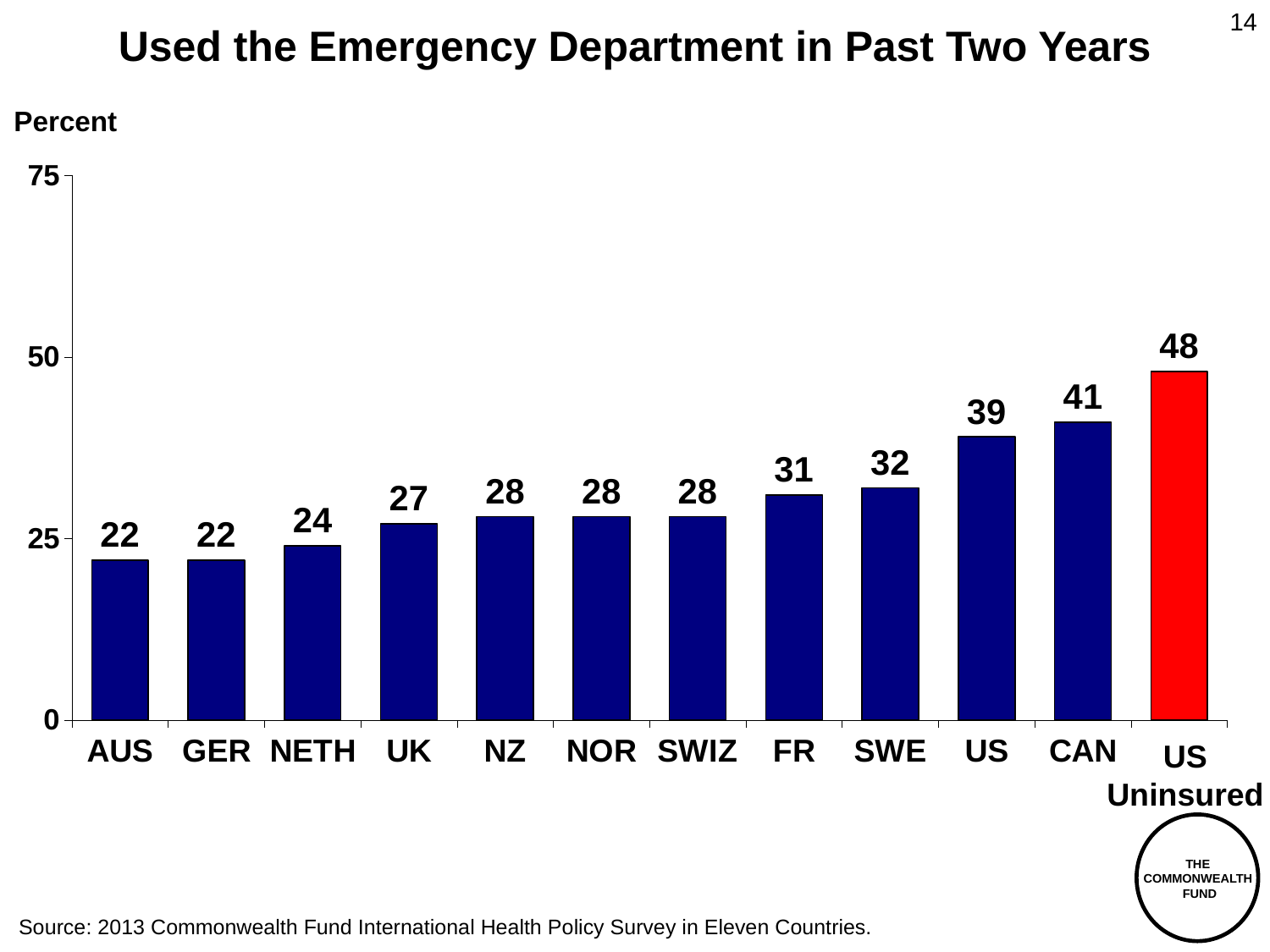
What is the difference between the values for CAN and the US? 2 Is the value for FR greater or less than 25? greater Which is larger, the value for SWE or the value for UK? SWE Which category has the highest value? US Uninsured What is the value for NETH? 24 What kind of chart is this? bar chart What is the value for US Uninsured? 48 How many categories are shown on the x axis? 12 Which bar is coloured red? US Uninsured What is the difference between the values for US Uninsured and AUS? 26 Do the values generally rise or fall from left to right along the x axis? rise What is the value for the US? 39